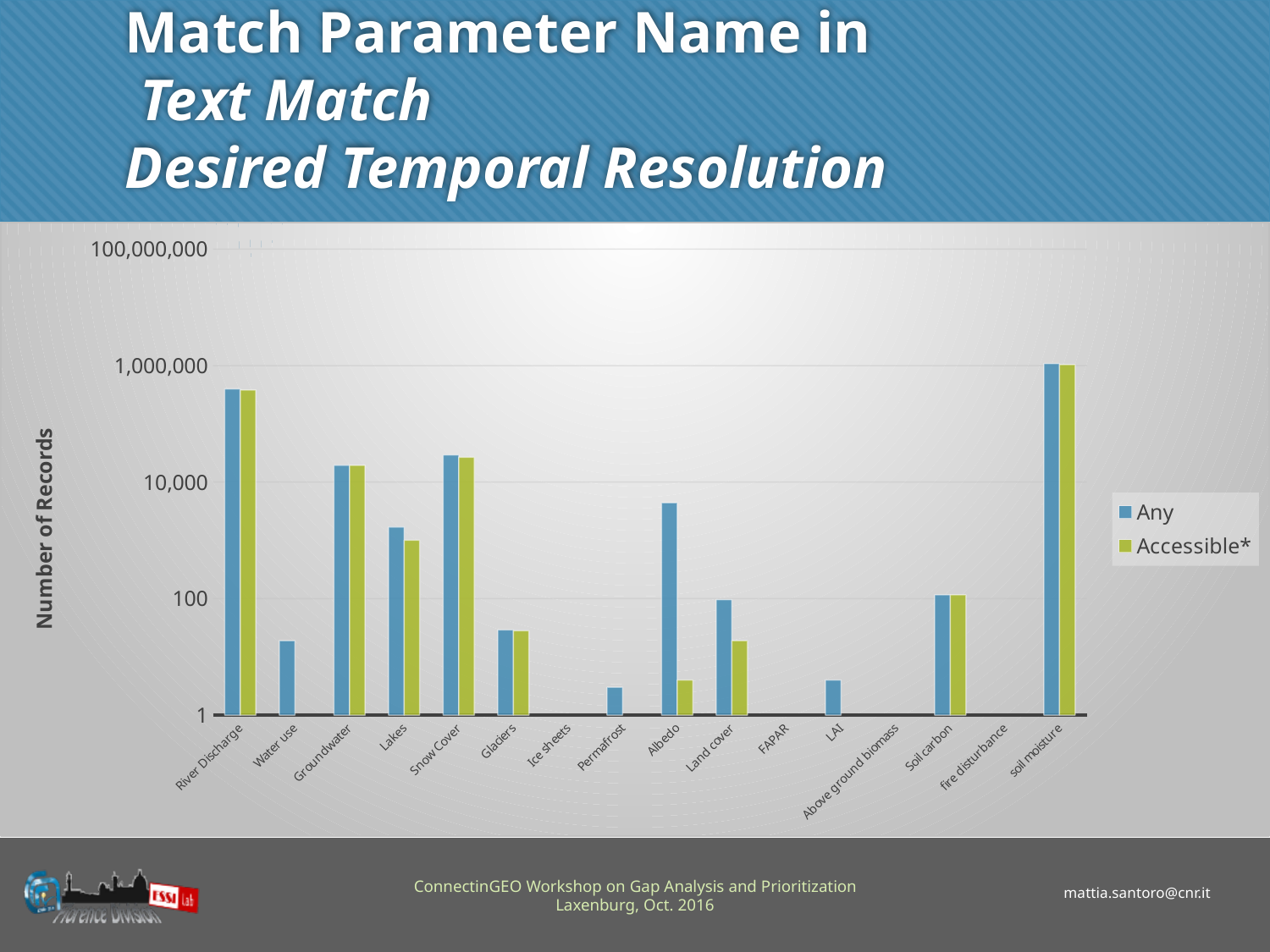
What is the title of the y axis? Number of Records How many categories are shown on the x axis? 16 Is the Accessible* value for Lakes greater or less than 100? greater How many series does the legend list? 2 For Land cover, which series has the larger value, Any or Accessible*? Any Is the Any value for Snow Cover greater or less than 10,000? greater What kind of chart is shown on the slide? bar chart Is the Any value for Albedo greater or less than 10,000? less Which category has the highest value for the Any series? soil moisture For Albedo, which series has the larger value, Any or Accessible*? Any